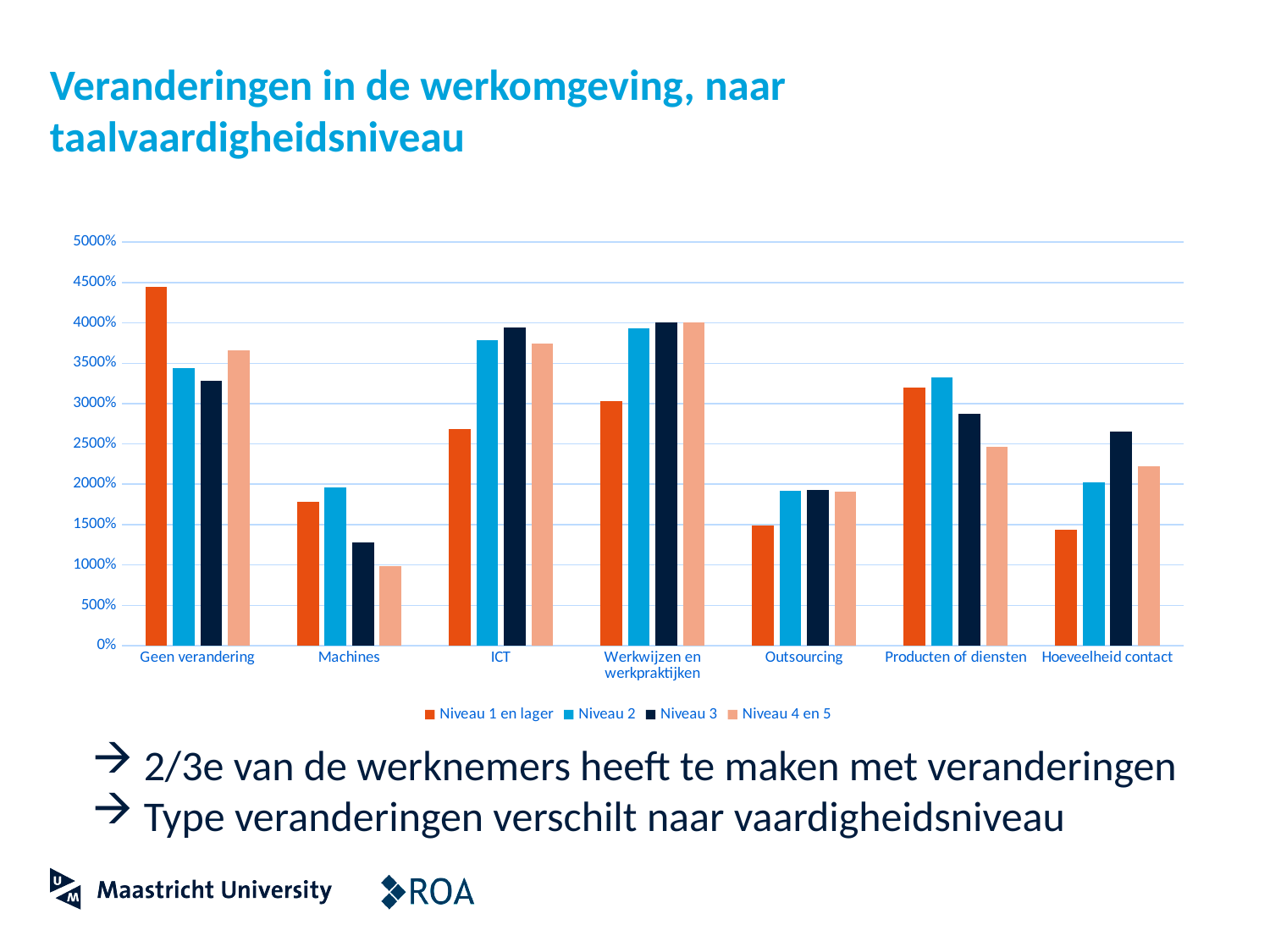
In the Machines category, which is larger: Niveau 2 or Niveau 3? Niveau 2 Which series has the lowest bar in the Hoeveelheid contact category? Niveau 1 en lager How many series does the chart's legend list? 4 Which category has the highest bar for Niveau 1 en lager? Geen verandering In the Hoeveelheid contact category, which is larger: Niveau 3 or Niveau 1 en lager? Niveau 3 What kind of chart is shown on the slide? bar chart What is the title of the chart on the slide? Veranderingen in de werkomgeving, naar taalvaardigheidsniveau Is the value for Niveau 1 en lager in Geen verandering greater or less than 4000%? greater How many categories are shown on the x axis of the chart? 7 Is the value for Niveau 4 en 5 in Machines greater or less than 1500%? less Which category has the lowest bar for Niveau 4 en 5? Machines Is the value for Niveau 3 in ICT greater or less than 3500%? greater